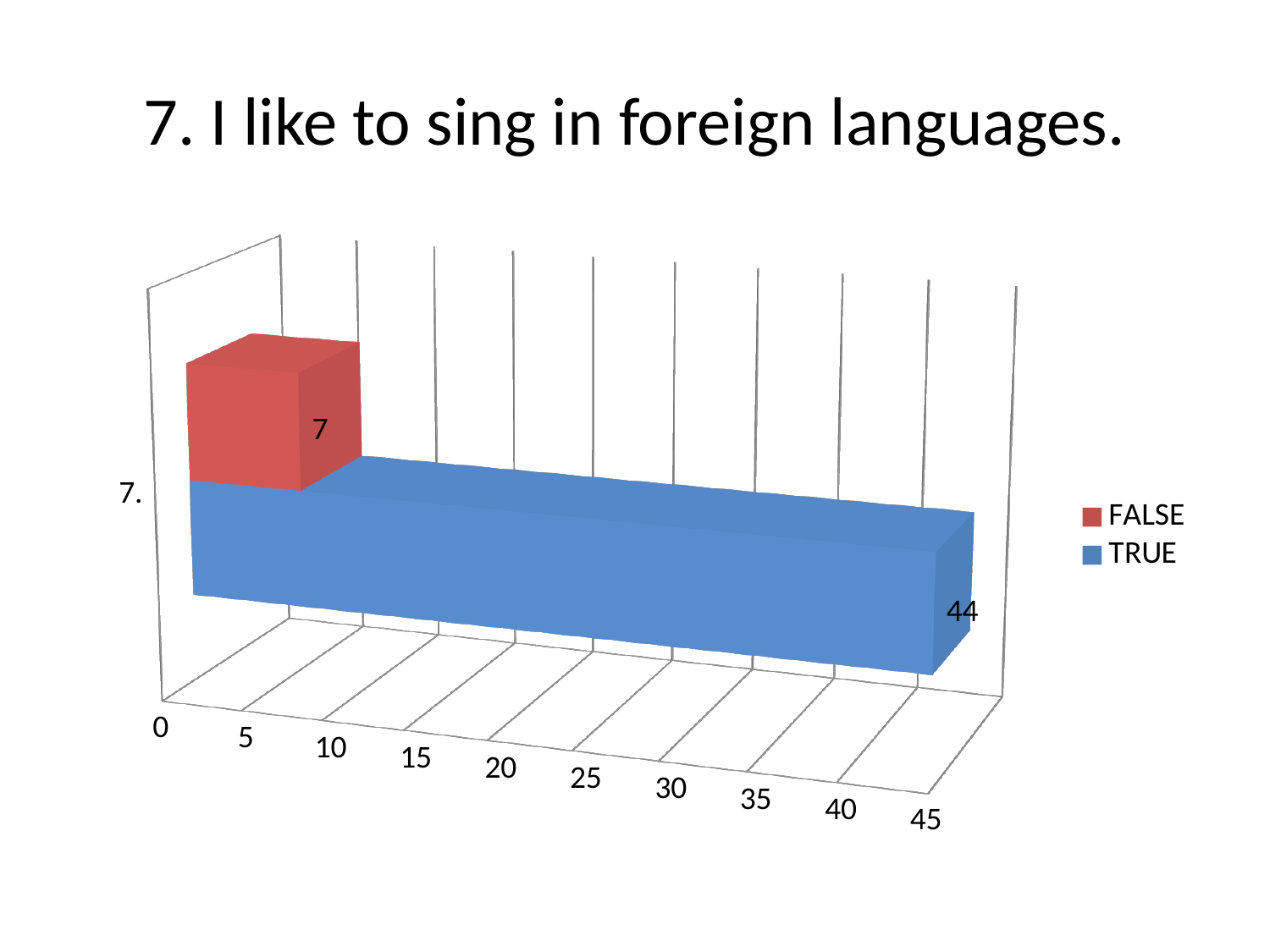
What is the value for FALSE? 7 Is the value for FALSE greater or less than 10? less What is the title of the slide? 7. I like to sing in foreign languages. What colour is the TRUE series in the legend? blue Which series has the higher value, TRUE or FALSE? TRUE What kind of chart is shown on the slide? bar chart How many series does the legend list? 2 Is the value for TRUE greater or less than 40? greater What is the value for TRUE? 44 Which series has the lowest value? FALSE What is the total of the TRUE and FALSE values? 51 What is the difference between the TRUE and FALSE values? 37